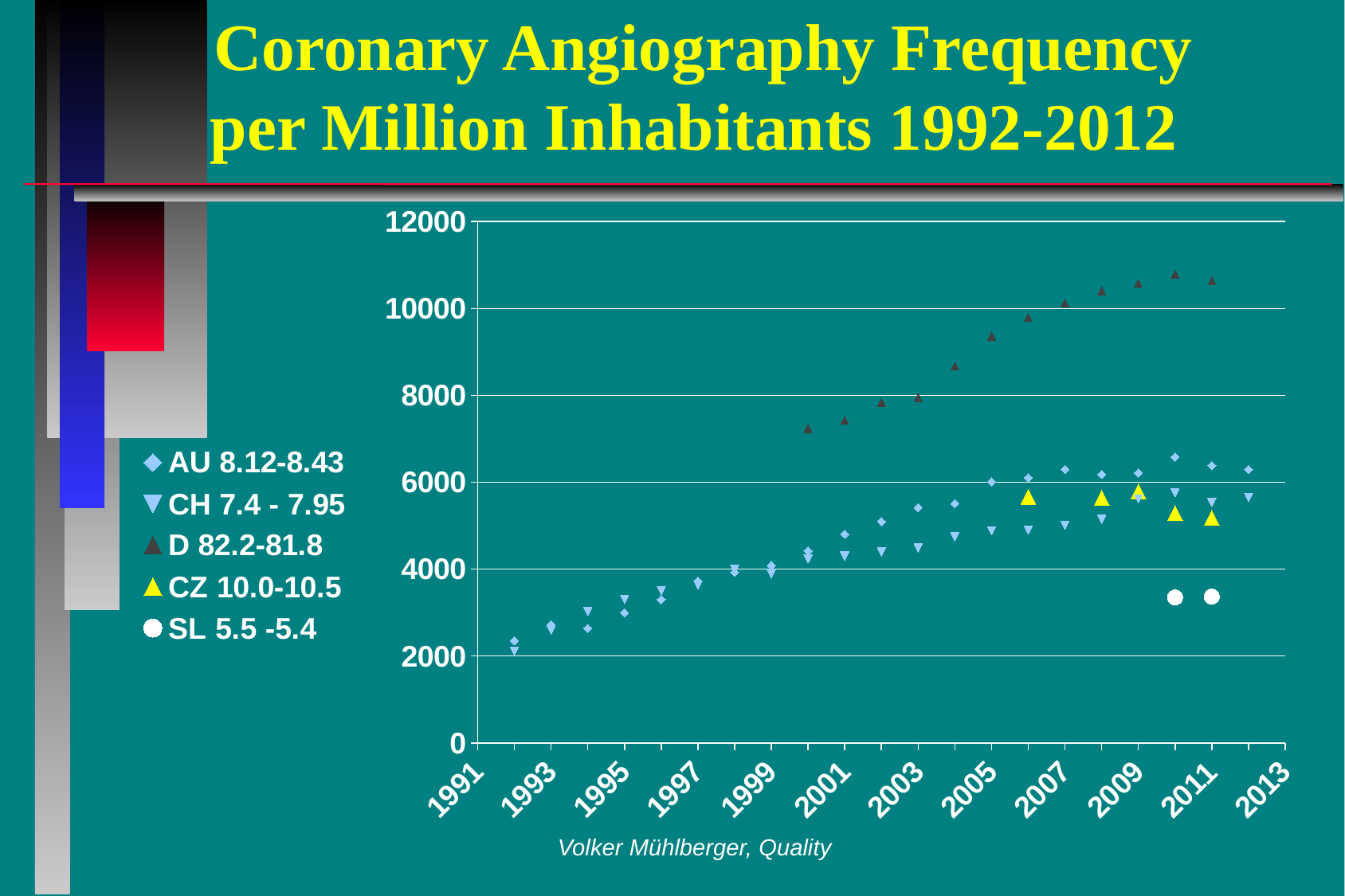
In 2011, which is larger, the value for CZ or the value for SL? CZ Is the value for D in 2000 greater or less than 8000? less In 2010, which is larger, the value for D or the value for AU? D Which series has the highest values on the chart? D What is the title of the chart? Coronary Angiography Frequency per Million Inhabitants 1992-2012 Do the values for D rise or fall from 2000 to 2012? rise What kind of chart is shown on the slide? scatter chart Is the value for AU in 2010 greater or less than 6000? greater How many series does the legend list? 5 Is the value for SL in 2011 greater or less than 4000? less Which series has the lowest values in 2011? SL